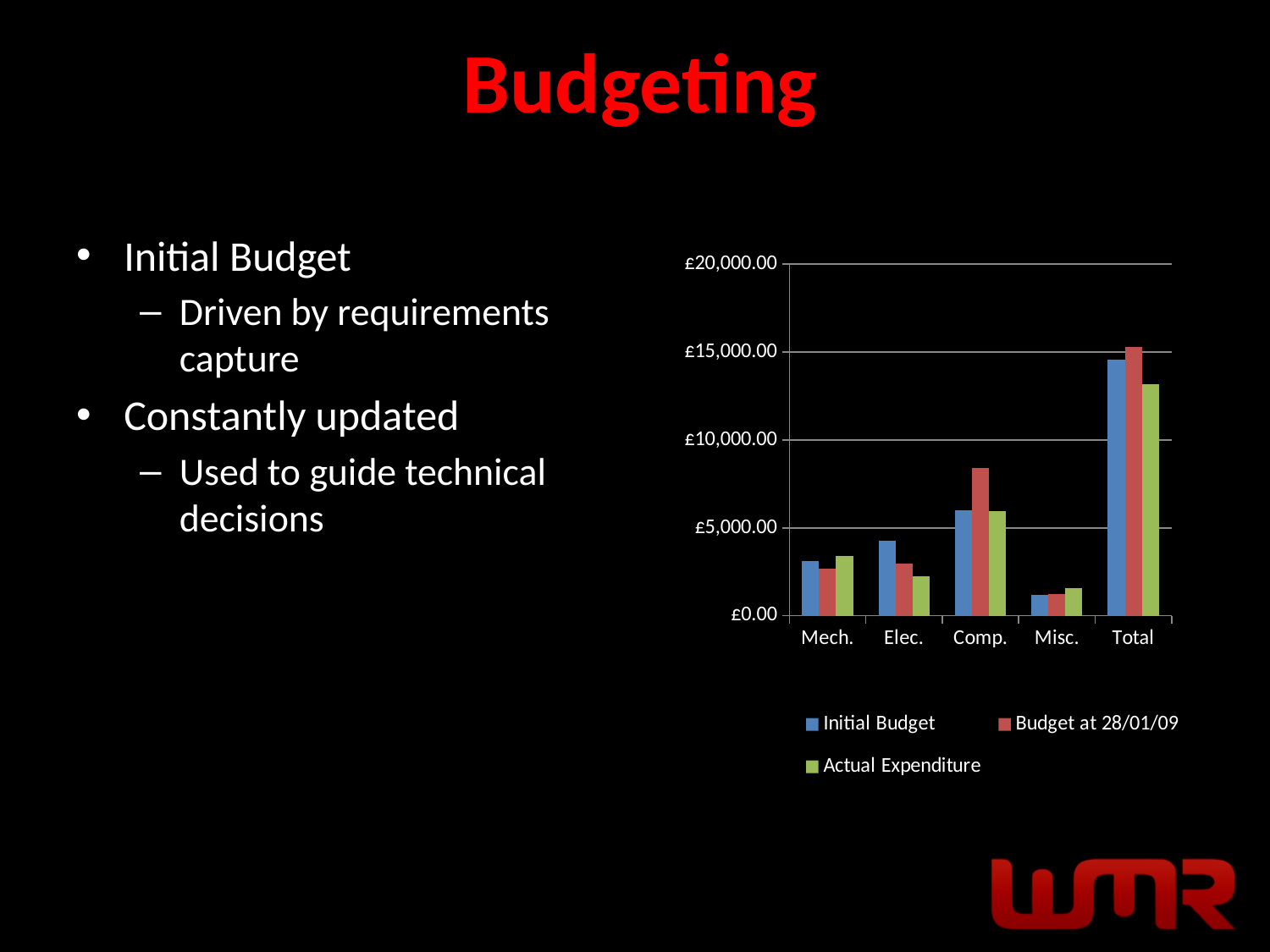
Which series is shown in green in the chart's legend? Actual Expenditure Is the Budget at 28/01/09 value for Comp. greater or less than £5,000.00? greater Is the Initial Budget value for Mech. greater or less than £5,000.00? less What kind of chart is shown on the slide? bar chart For Comp., which is larger: the Initial Budget or the Budget at 28/01/09? Budget at 28/01/09 For Elec., which is larger: the Initial Budget or the Actual Expenditure? Initial Budget How many series does the chart's legend list? 3 How many categories are shown on the x axis of the chart? 5 Which category has the highest Initial Budget value? Total Is the Initial Budget value for Total greater or less than £15,000.00? less Which category has the lowest Actual Expenditure value? Misc.